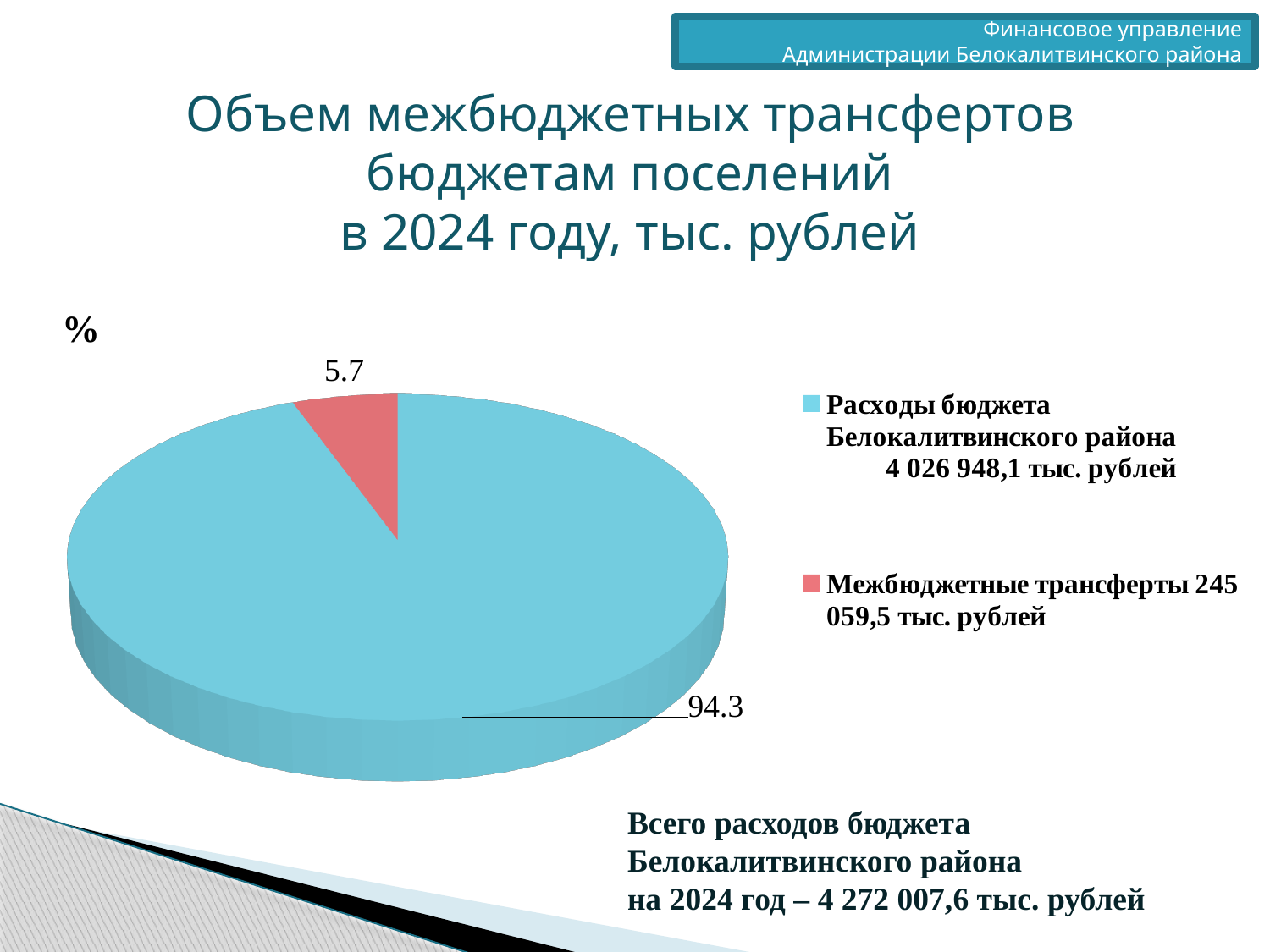
What colour is the slice for "Межбюджетные трансферты"? red What percentage share is shown for the slice labelled "Межбюджетные трансферты 245 059,5 тыс. рублей"? 5.7 What kind of chart is shown on the slide? pie chart Which slice of the pie is the largest? Расходы бюджета Белокалитвинского района 4 026 948,1 тыс. рублей What percentage share is shown for the slice labelled "Расходы бюджета Белокалитвинского района 4 026 948,1 тыс. рублей"? 94.3 Is the share for "Межбюджетные трансферты" greater or less than 10%? less What is the difference in percentage points between the two slices of the pie? 88.6 Which is larger: the share for "Расходы бюджета Белокалитвинского района" or the share for "Межбюджетные трансферты"? Расходы бюджета Белокалитвинского района How many entries does the legend list? 2 Which slice of the pie is the smallest? Межбюджетные трансферты 245 059,5 тыс. рублей How many slices does the pie chart have? 2 What unit symbol is shown above the pie chart? %